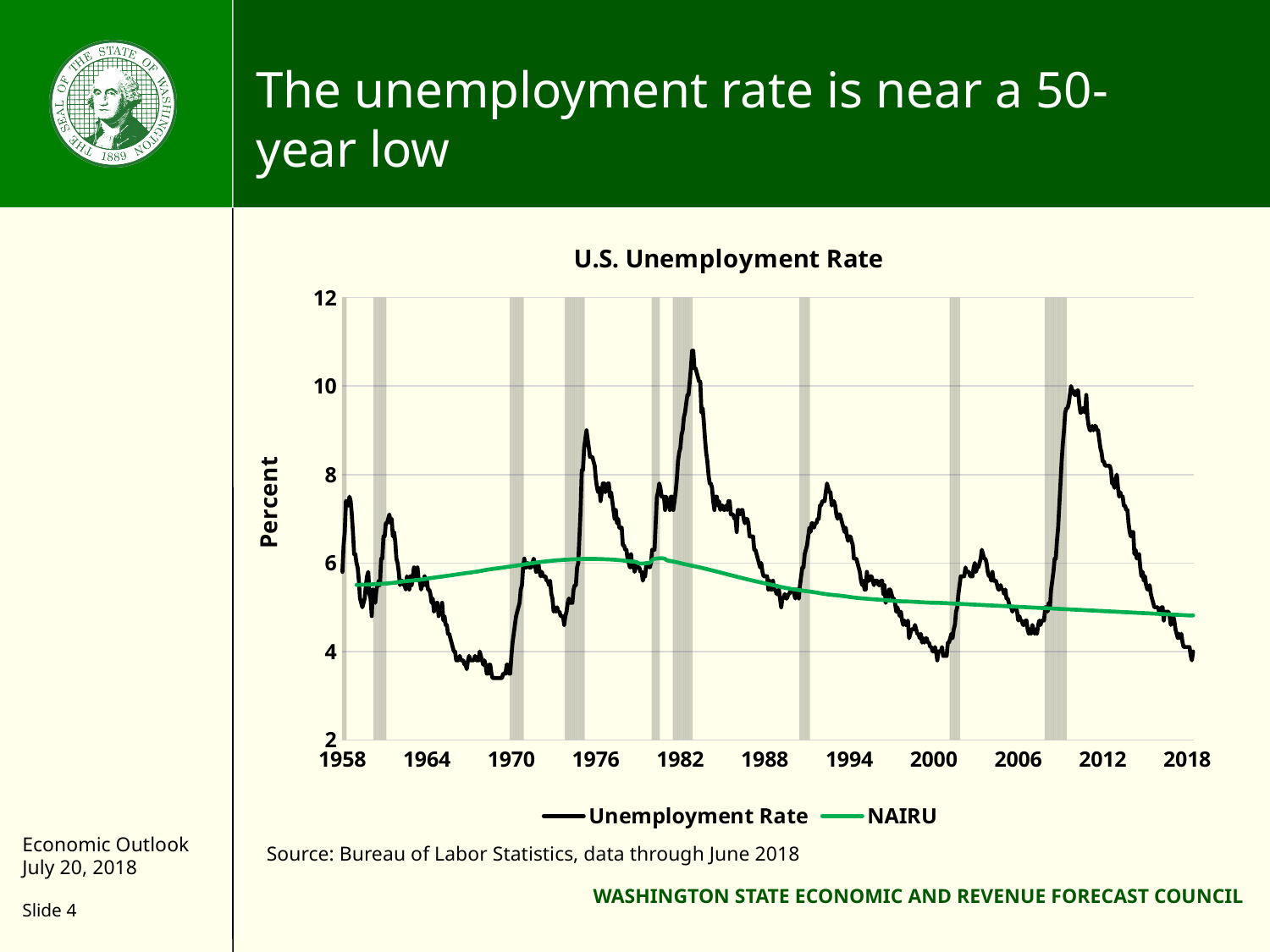
What type of chart is shown on the slide? Line chart Is the NAIRU value in 2018 greater or less than 6? less Is the Unemployment Rate in 1992 greater or less than 6? greater Does the Unemployment Rate rise or fall between 2010 and 2018? Falls How many series does the legend of the U.S. Unemployment Rate chart list? 2 Does the NAIRU series rise or fall between 1982 and 2018? Falls Is the peak value of the Unemployment Rate in the early 1980s greater or less than 10? greater Which is higher in 2018, the Unemployment Rate or the NAIRU? NAIRU What is the label on the vertical axis of the chart? Percent What is the title of the chart? U.S. Unemployment Rate